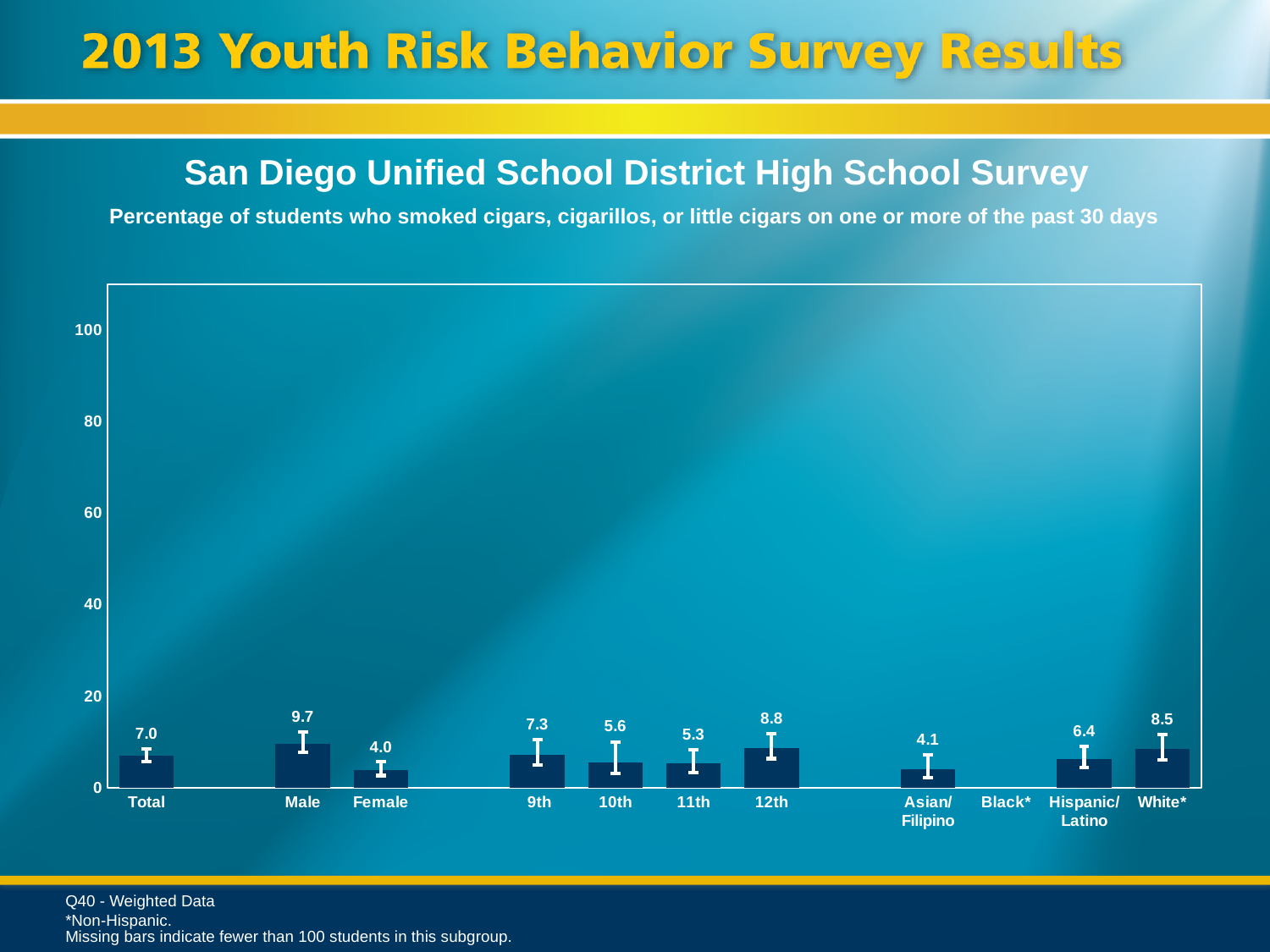
What is the value for Asian/Filipino? 4.1 What is the value for Male? 9.7 What is the value for 12th grade? 8.8 Which category label has no bar shown? Black* Which category with a bar has the lowest value? Female What is the value for Female? 4.0 Is the value for White* greater or less than 20? less What is the value for Total? 7.0 What kind of chart is shown? bar chart What is the difference between the Male and Female values? 5.7 Which is larger, the value for 9th grade or 11th grade? 9th Which category has the highest value? Male